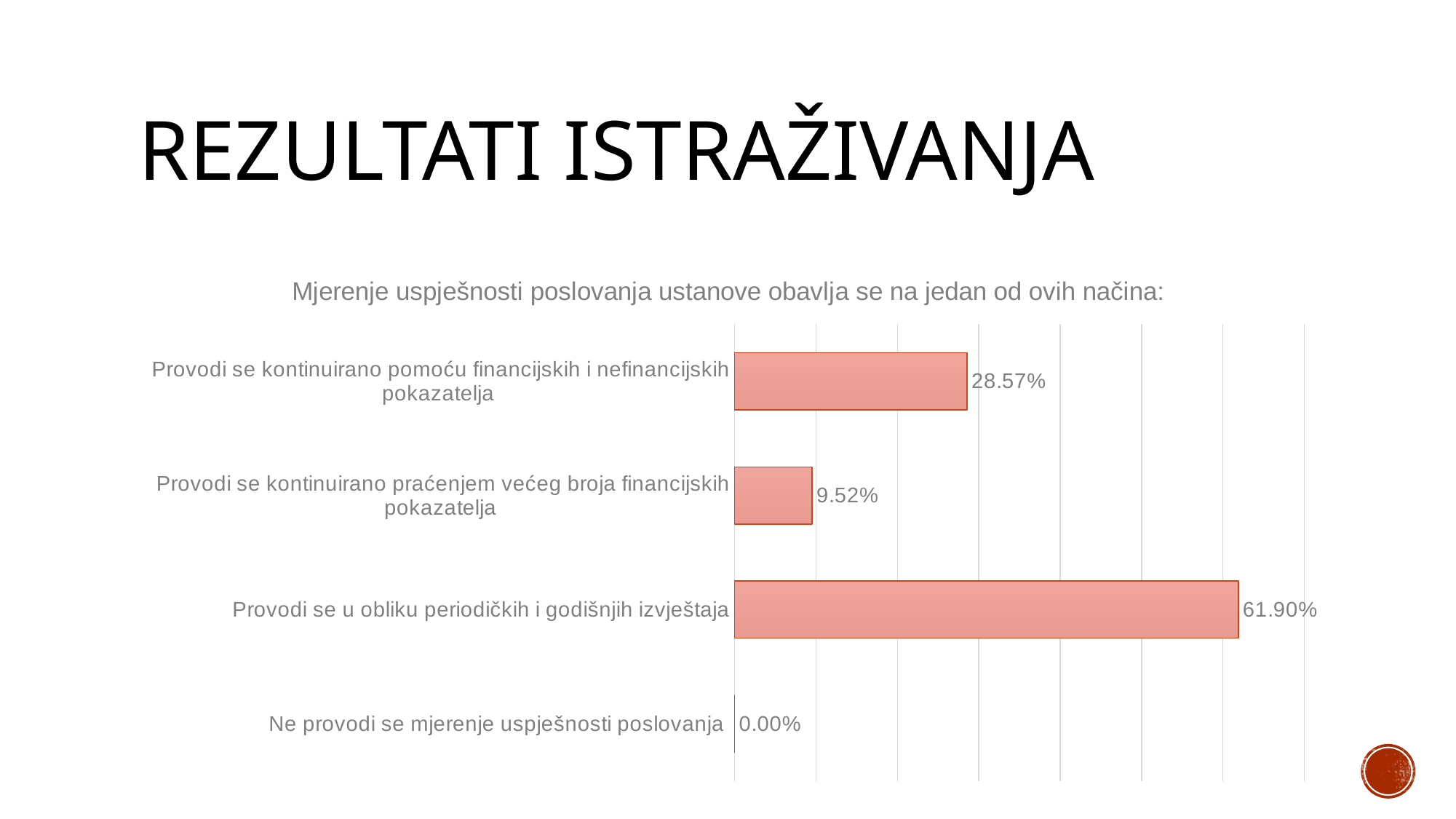
How many categories does the chart show? 4 Which category has the lowest value? Ne provodi se mjerenje uspješnosti poslovanja What is the value for "Provodi se u obliku periodičkih i godišnjih izvještaja"? 61.90% Which is larger: the value for "Provodi se kontinuirano pomoću financijskih i nefinancijskih pokazatelja" or for "Provodi se kontinuirano praćenjem većeg broja financijskih pokazatelja"? Provodi se kontinuirano pomoću financijskih i nefinancijskih pokazatelja What is the value for "Provodi se kontinuirano pomoću financijskih i nefinancijskih pokazatelja"? 28.57% What is the value for "Ne provodi se mjerenje uspješnosti poslovanja"? 0.00% What is the title of the chart? Mjerenje uspješnosti poslovanja ustanove obavlja se na jedan od ovih načina: What is the value for "Provodi se kontinuirano praćenjem većeg broja financijskih pokazatelja"? 9.52% What kind of chart is shown on the slide? Bar chart What is the difference between the values for "Provodi se kontinuirano pomoću financijskih i nefinancijskih pokazatelja" and "Provodi se kontinuirano praćenjem većeg broja financijskih pokazatelja"? 19.05% What is the difference between the values for "Provodi se u obliku periodičkih i godišnjih izvještaja" and "Provodi se kontinuirano pomoću financijskih i nefinancijskih pokazatelja"? 33.33% Which category has the highest value? Provodi se u obliku periodičkih i godišnjih izvještaja